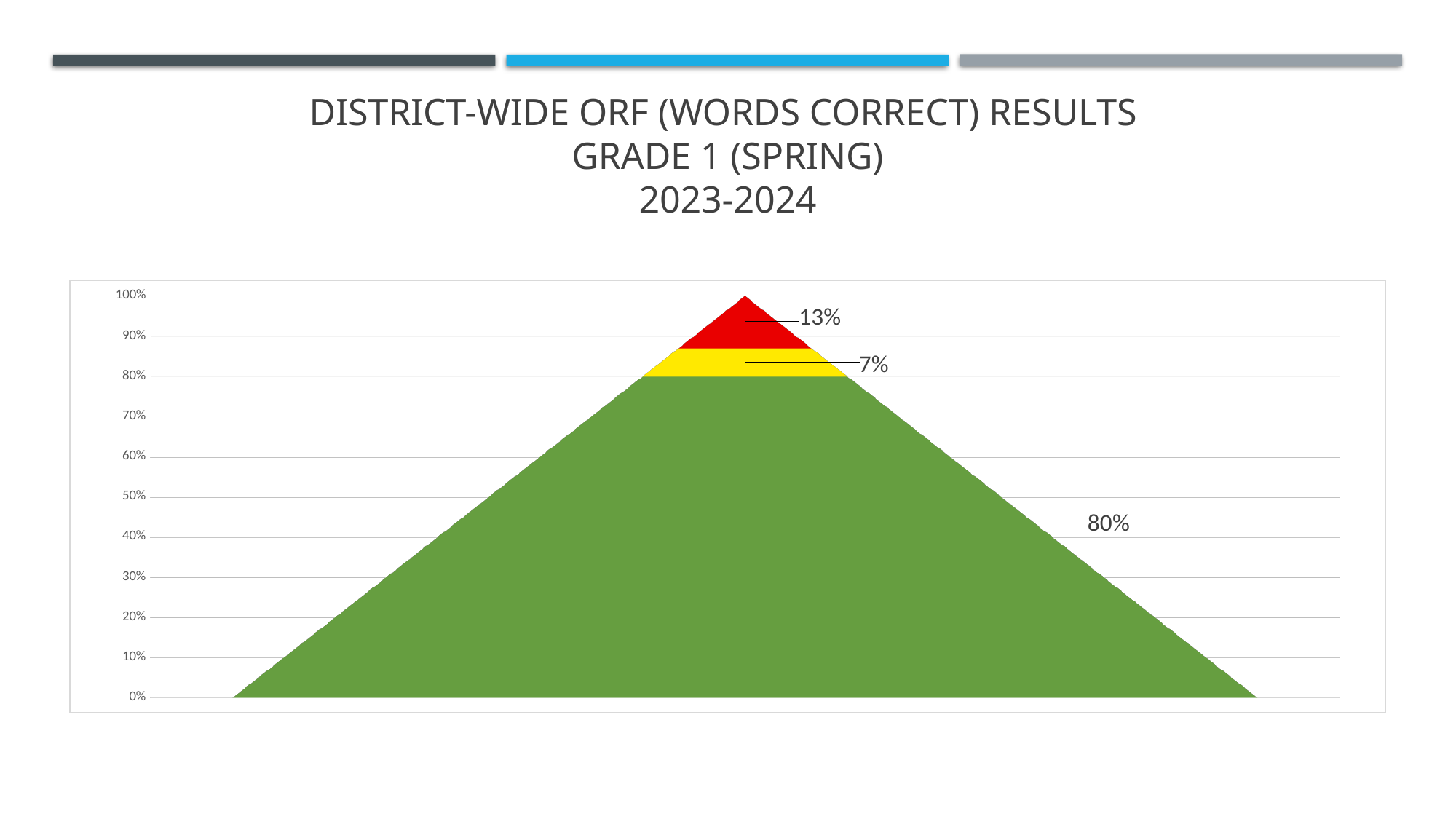
What is the difference between the red segment's value and the yellow segment's value? 6% What percentage is shown for the yellow segment of the pyramid? 7% What percentage is shown for the red segment at the top of the pyramid? 13% Which segment of the pyramid has the largest value? The green segment (80%) How many segments make up the pyramid? 3 What is the title of the slide containing the chart? District-Wide ORF (Words Correct) Results Grade 1 (Spring) 2023-2024 What percentage is shown for the green segment of the pyramid? 80% Which segment of the pyramid has the smallest value? The yellow segment (7%) Which is larger, the red segment's value or the yellow segment's value? The red segment (13%) What is the total of the three segments in the pyramid? 100% What is the highest value shown on the vertical axis of the chart? 100% What is the difference between the green segment's value and the red segment's value? 67%